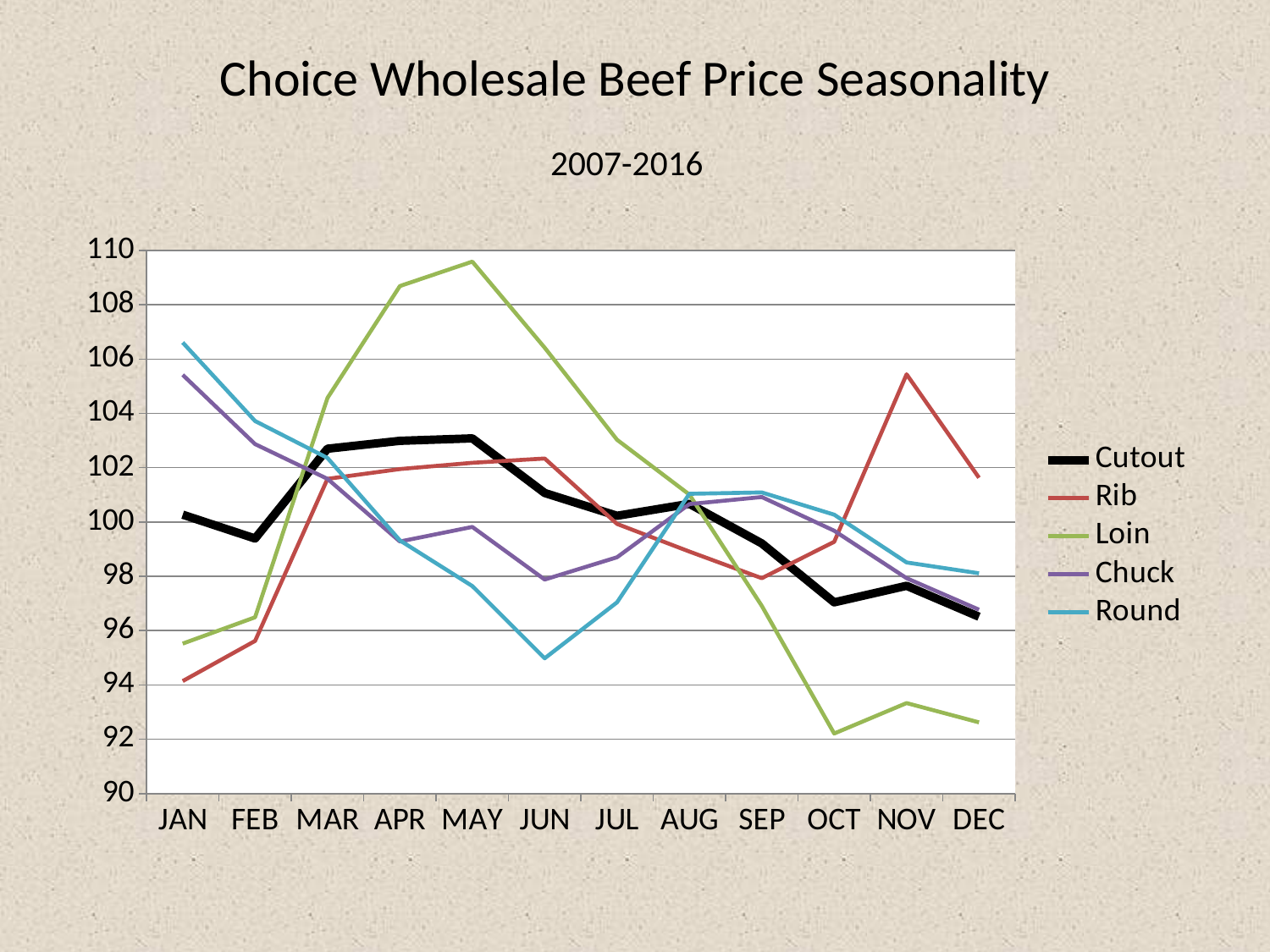
Does the Loin series rise or fall from MAY to OCT? fall Which series is drawn with the thick black line? Cutout Which series has the highest value in NOV? Rib Is the value for Rib in JAN greater or less than 96? less How many months are shown along the x axis? 12 Is the value for Loin in MAY greater or less than 108? greater In JAN, which is larger, the value for Round or the value for Rib? Round Is the value for Round in JUN greater or less than 96? less How many series does the legend list? 5 What kind of chart is shown on the slide? line chart Which series has the lowest value in OCT? Loin Which series has the highest value in MAY? Loin